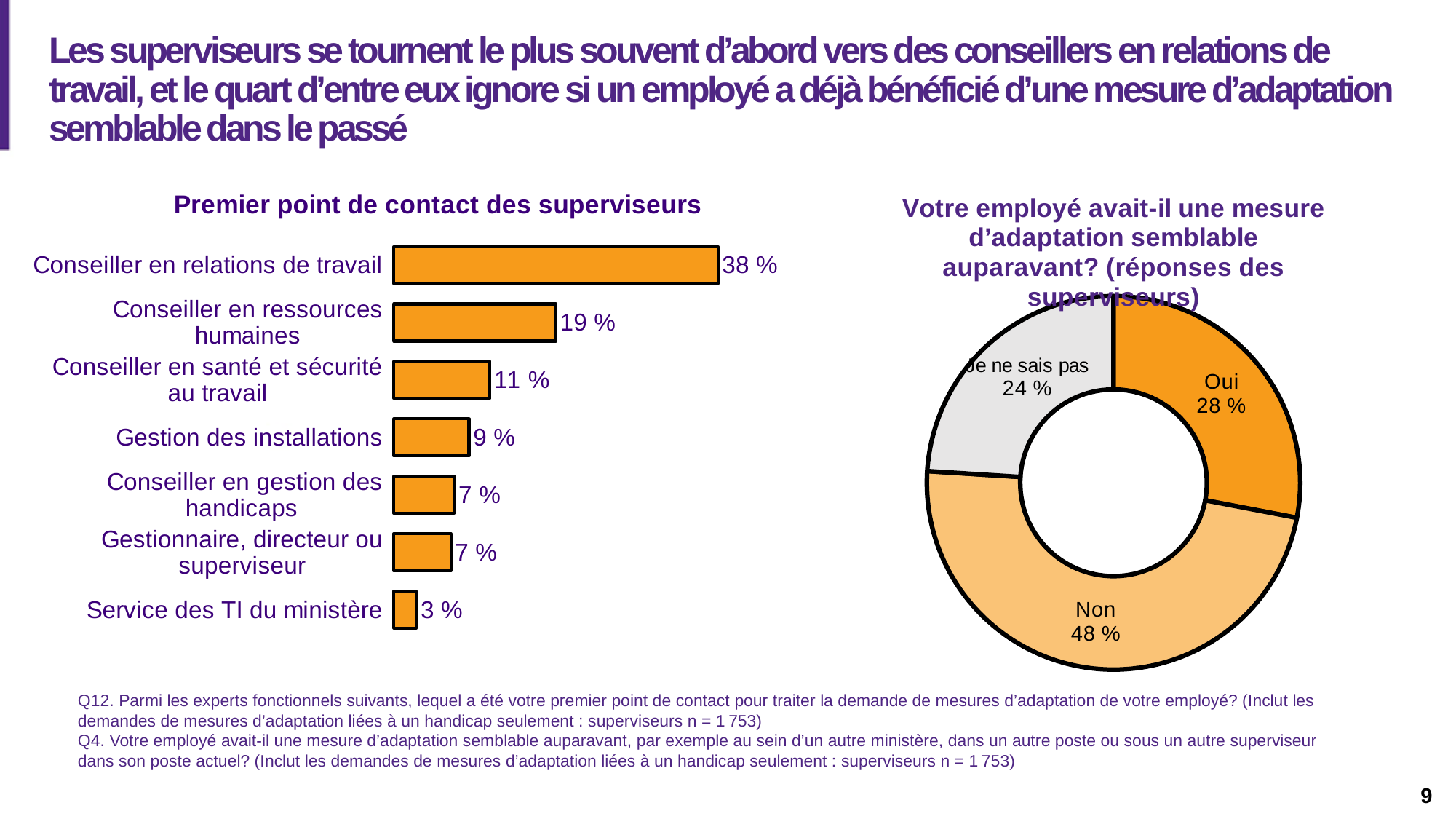
In the donut chart on the right, which response has the largest share? Non In the 'Premier point de contact des superviseurs' chart, what is the value for 'Conseiller en santé et sécurité au travail'? 11 % How many slices does the donut chart on the right have? 3 In the 'Premier point de contact des superviseurs' chart, which category has the highest value? Conseiller en relations de travail In the donut chart on the right, what share of supervisors answered 'Non'? 48 % In the 'Premier point de contact des superviseurs' chart, which is larger: 'Gestion des installations' or 'Conseiller en gestion des handicaps'? Gestion des installations In the 'Premier point de contact des superviseurs' chart, what is the difference between 'Conseiller en relations de travail' and 'Conseiller en ressources humaines'? 19 % What kind of chart is 'Premier point de contact des superviseurs'? Bar chart How many categories are shown in the 'Premier point de contact des superviseurs' chart? 7 In the 'Premier point de contact des superviseurs' chart, which category has the lowest value? Service des TI du ministère In the 'Premier point de contact des superviseurs' chart, what is the value for 'Conseiller en relations de travail'? 38 % In the donut chart on the right, what is the value for 'Je ne sais pas'? 24 %